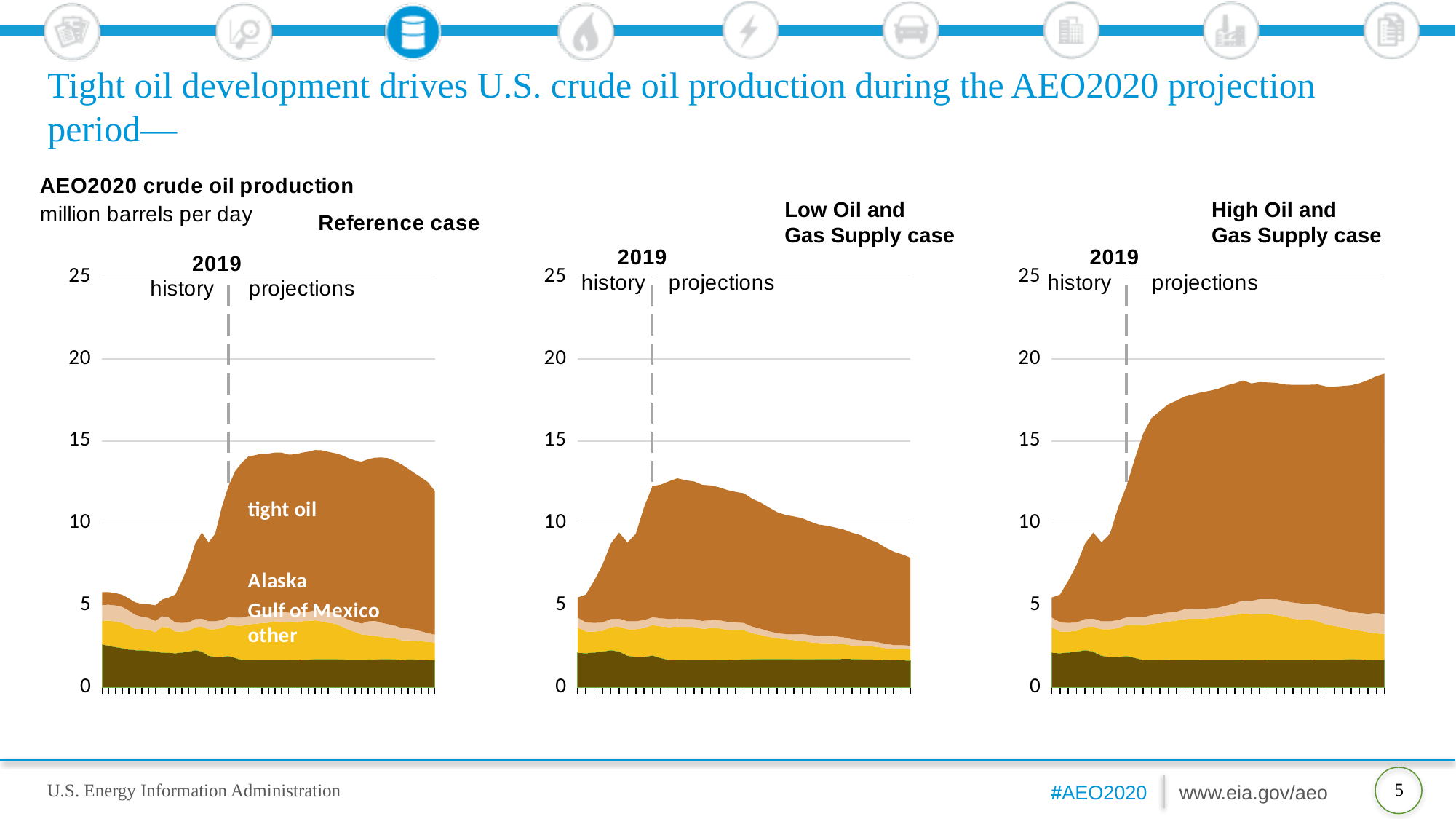
In the Low Oil and Gas Supply case chart, does total crude oil production rise or fall over the projection period after its early peak? fall Which of the three cases shows the lowest total crude oil production at the end of the projection period? Low Oil and Gas Supply case In the Reference case chart, which category forms the largest part of the stack during the projection period? tight oil In the Reference case chart, is total crude oil production at the end of the projection period greater or less than 10? greater What kind of chart is the Reference case chart? stacked area chart Which of the three cases shows the highest total crude oil production at the end of the projection period? High Oil and Gas Supply case In the High Oil and Gas Supply case chart, is total crude oil production at the end of the projection period greater or less than 15? greater What unit is used on the y axis of the charts? million barrels per day In the Reference case chart, does total crude oil production ever exceed 15 million barrels per day? no In the High Oil and Gas Supply case chart, does total crude oil production rise or fall over the projection period? rise How many production categories are labelled in the Reference case chart? 4